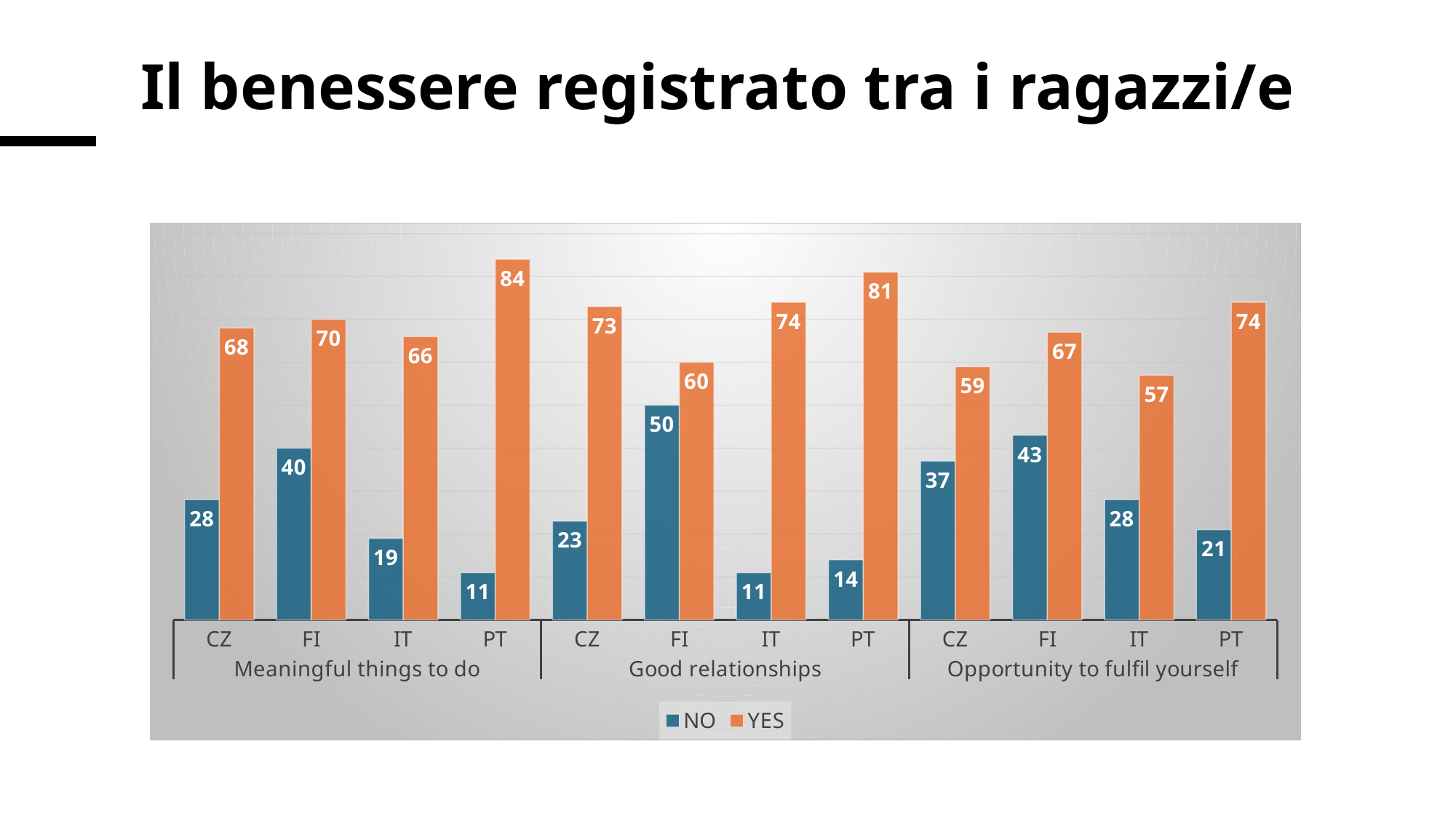
What is the YES value for PT under "Meaningful things to do"? 84 What colour are the YES bars? Orange What is the difference between the YES and NO values for CZ under "Meaningful things to do"? 40 Which country has the lowest NO value under "Opportunity to fulfil yourself"? PT What is the YES value for IT under "Opportunity to fulfil yourself"? 57 Which is larger: the NO value for FI under "Meaningful things to do" or the NO value for FI under "Opportunity to fulfil yourself"? FI under Opportunity to fulfil yourself What kind of chart is shown on the slide? Bar chart What is the NO value for FI under "Good relationships"? 50 Which country has the highest YES value under "Good relationships"? PT What is the difference between the YES values for PT and IT under "Good relationships"? 7 How many series does the legend list? 2 How many category groups are shown on the x axis? 3